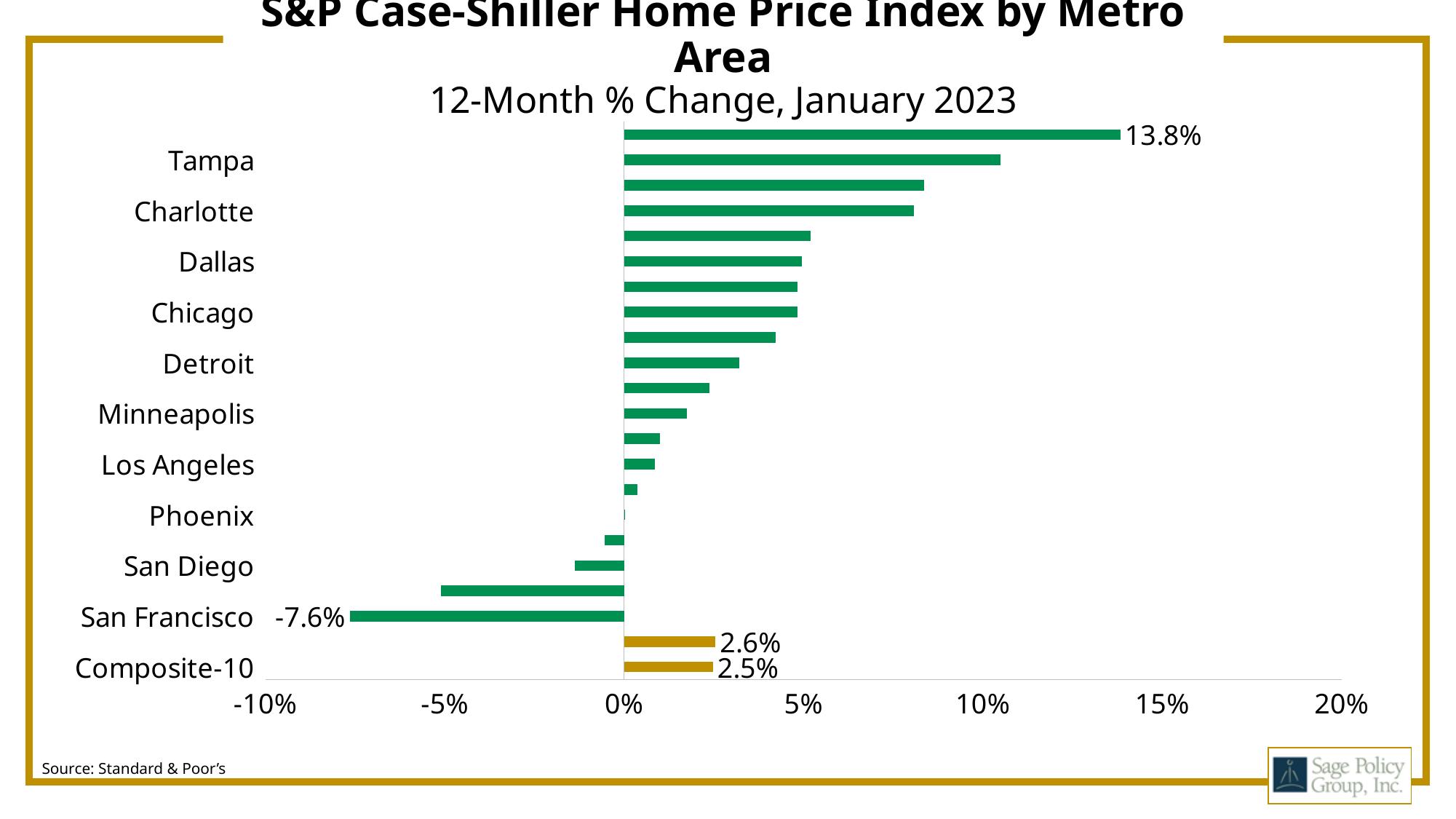
Which labeled metro area has the lowest 12-month % change? San Francisco What is the 12-month % change for Composite-10? 2.5% Which has a larger 12-month % change, Tampa or Charlotte? Tampa Which has a larger 12-month % change, Chicago or Detroit? Chicago What is the difference between the Composite-10 value and the San Francisco value? 10.1 percentage points What period does the chart's subtitle say the data covers? 12-Month % Change, January 2023 Is the value for San Diego greater or less than 0%? less What kind of chart is shown on the slide? bar chart What is the largest value shown on the chart? 13.8% What is the 12-month % change for San Francisco? -7.6% How many bars are shown in gold rather than green? 2 Is the value for Dallas greater or less than 10%? less